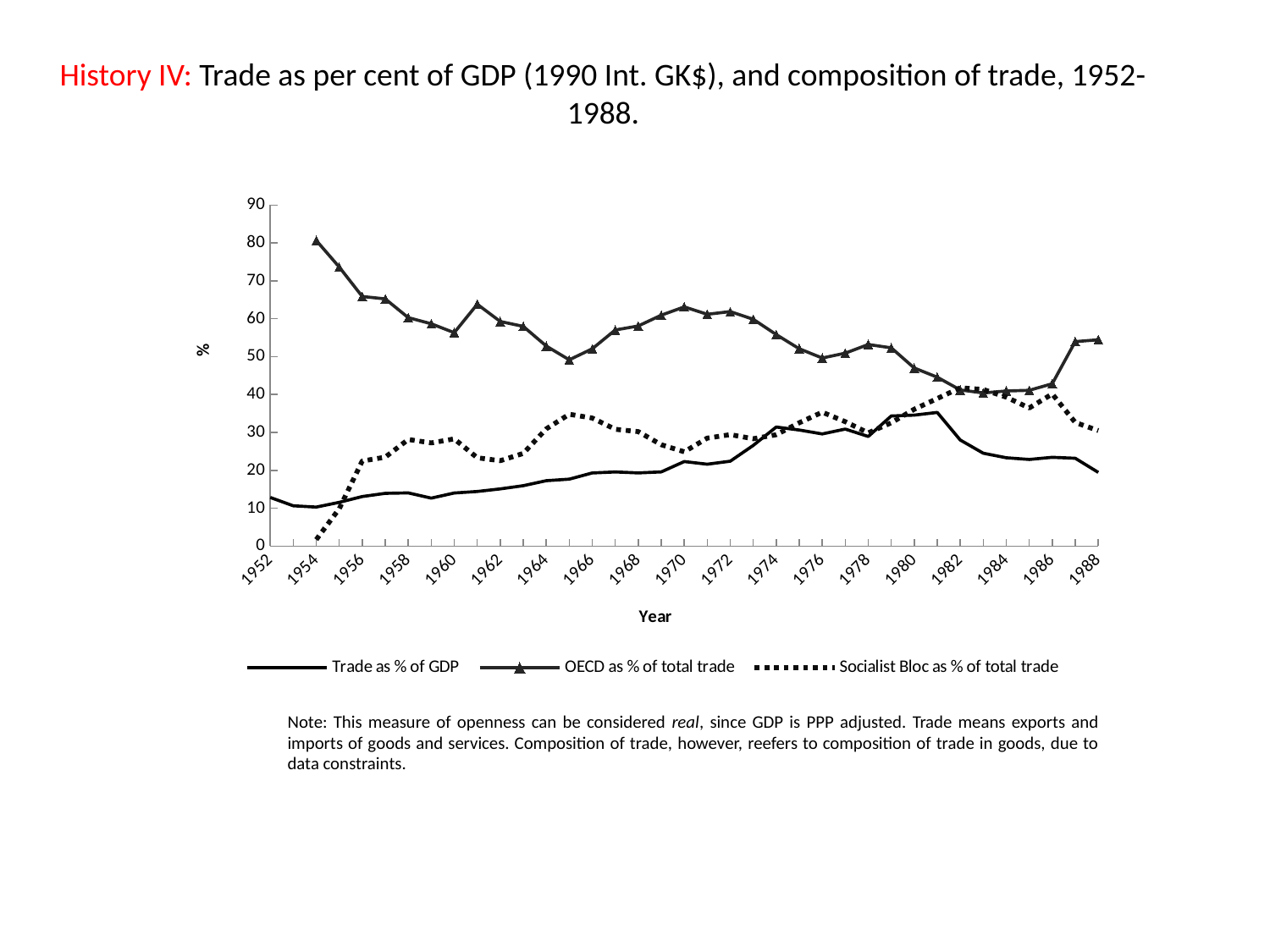
Which series has the highest value in 1954? OECD as % of total trade How many series does the legend list? 3 What kind of chart is shown on the slide? line chart Does Socialist Bloc as % of total trade rise or fall between 1954 and 1965? rise Which series is drawn with a dotted line? Socialist Bloc as % of total trade In 1954, which is larger: OECD as % of total trade or Socialist Bloc as % of total trade? OECD as % of total trade Is the value for OECD as % of total trade in 1988 greater or less than 50? greater What is the label on the x axis of the chart? Year Does OECD as % of total trade rise or fall between 1954 and 1965? fall Is the value for Socialist Bloc as % of total trade in 1954 greater or less than 10? less Is the value for Trade as % of GDP in 1988 greater or less than 30? less